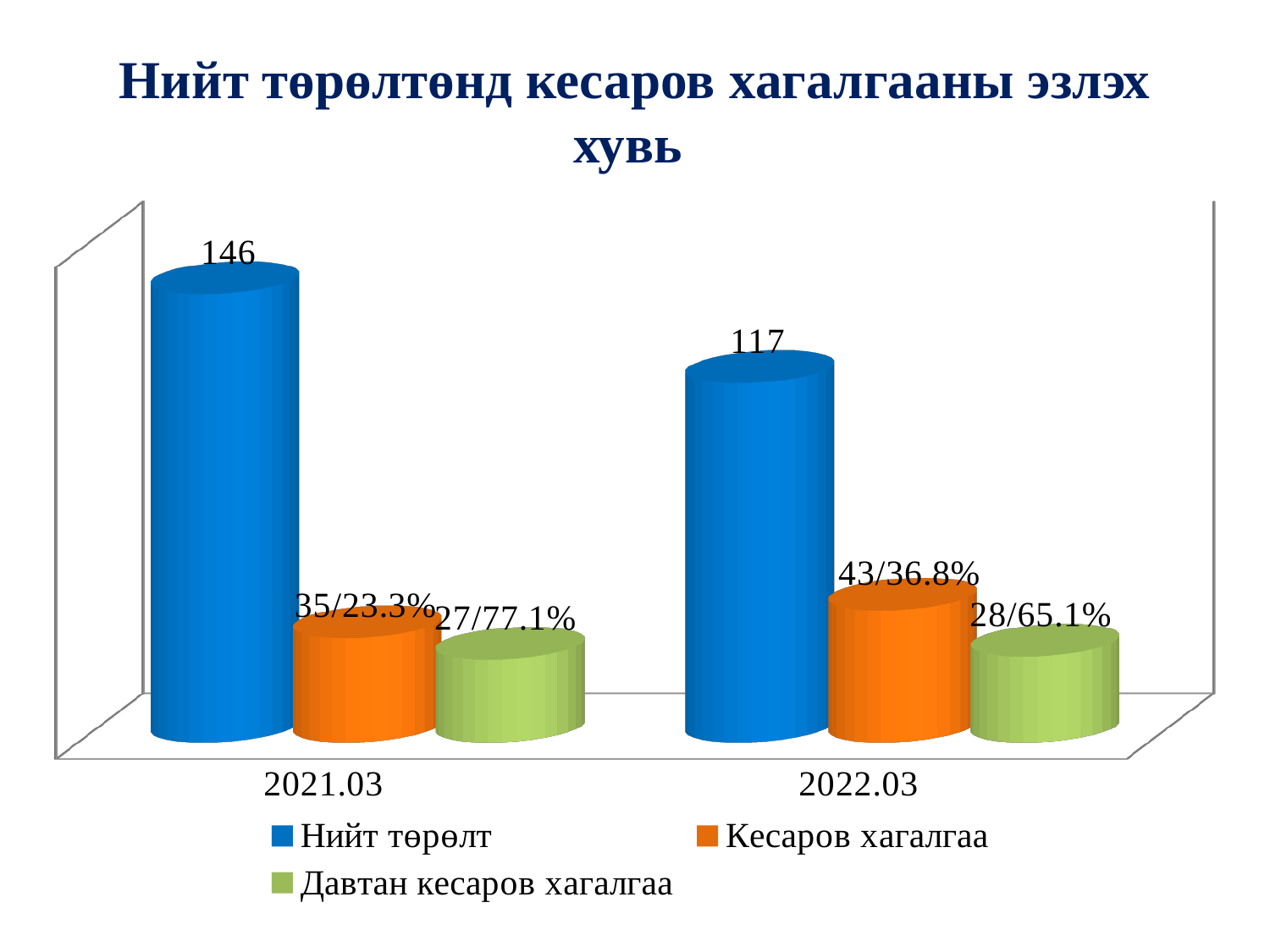
Which is larger: Нийт төрөлт in 2021.03 or in 2022.03? 2021.03 How many categories are shown on the x axis? 2 What kind of chart is shown on the slide? Bar chart What is the value for Нийт төрөлт in 2021.03? 146 What is the difference in Нийт төрөлт between 2021.03 and 2022.03? 29 How many series does the legend list? 3 In which period is Нийт төрөлт highest? 2021.03 What data label is shown for Кесаров хагалгаа in 2021.03? 35/23.3% What data label is shown for Давтан кесаров хагалгаа in 2022.03? 28/65.1% What is the value for Нийт төрөлт in 2022.03? 117 What data label is shown for Давтан кесаров хагалгаа in 2021.03? 27/77.1% What data label is shown for Кесаров хагалгаа in 2022.03? 43/36.8%